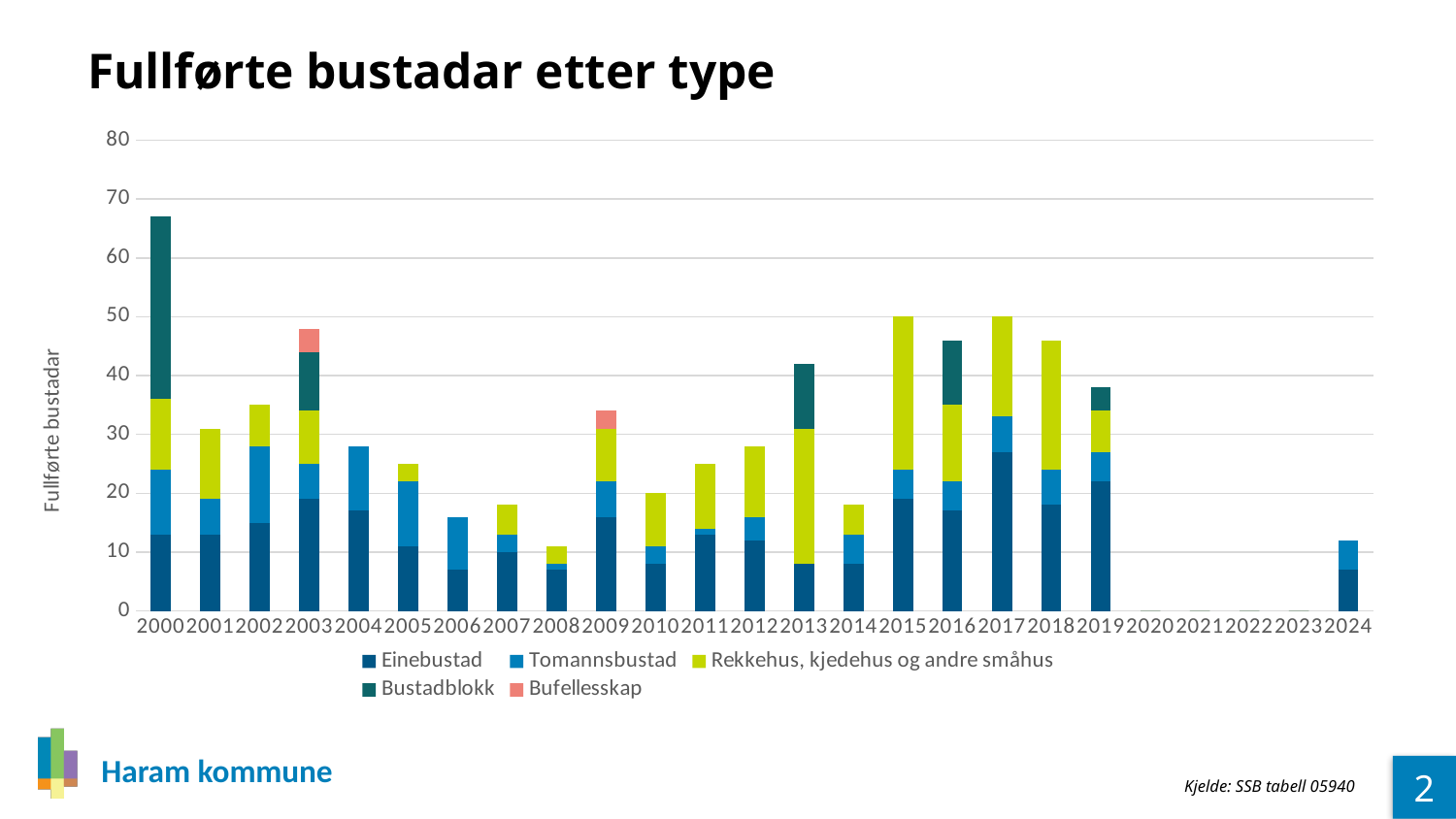
Is the total for 2000 greater or less than 60? greater Which series is shown in the salmon/pink colour in the legend? Bufellesskap Which year has the larger total, 2013 or 2014? 2013 Is the total for 2019 greater or less than 40? less What is the title of the chart? Fullførte bustadar etter type Which year has the tallest stacked bar? 2000 How many years are shown on the x axis? 25 Which year has the larger total, 2015 or 2019? 2015 How many series does the legend list? 5 Is the total for 2013 greater or less than 40? greater What kind of chart is shown on the slide? Stacked bar chart